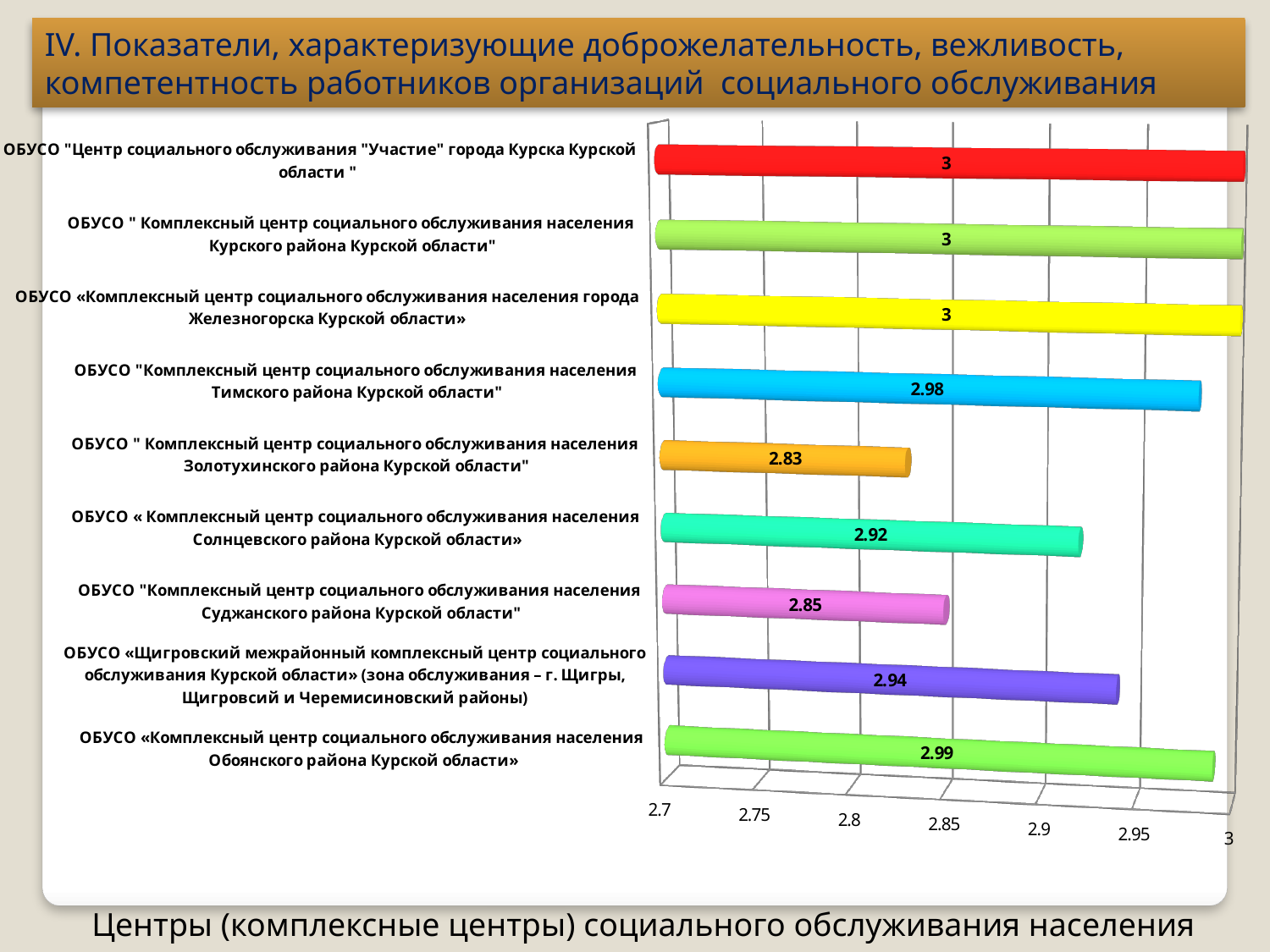
Which has the larger value: the Солнцевского района centre or the Суджанского района centre? Солнцевского района centre What is the difference between the values for the Обоянского района centre and the Золотухинского района centre? 0.16 What colour is the bar for the Золотухинского района centre? orange What is the value for ОБУСО «Комплексный центр социального обслуживания населения Обоянского района Курской области»? 2.99 What kind of chart is shown on the slide? bar chart What is the value for ОБУСО "Комплексный центр социального обслуживания населения Тимского района Курской области"? 2.98 Which organisation has the lowest value on the chart? ОБУСО "Комплексный центр социального обслуживания населения Золотухинского района Курской области" What is the value for ОБУСО «Щигровский межрайонный комплексный центр социального обслуживания Курской области»? 2.94 Is the value for the Тимского района centre greater or less than 2.95? greater What is the minimum value shown on the horizontal axis? 2.7 How many organisations have a value of exactly 3? 3 How many organisations (bars) are shown on the chart? 9